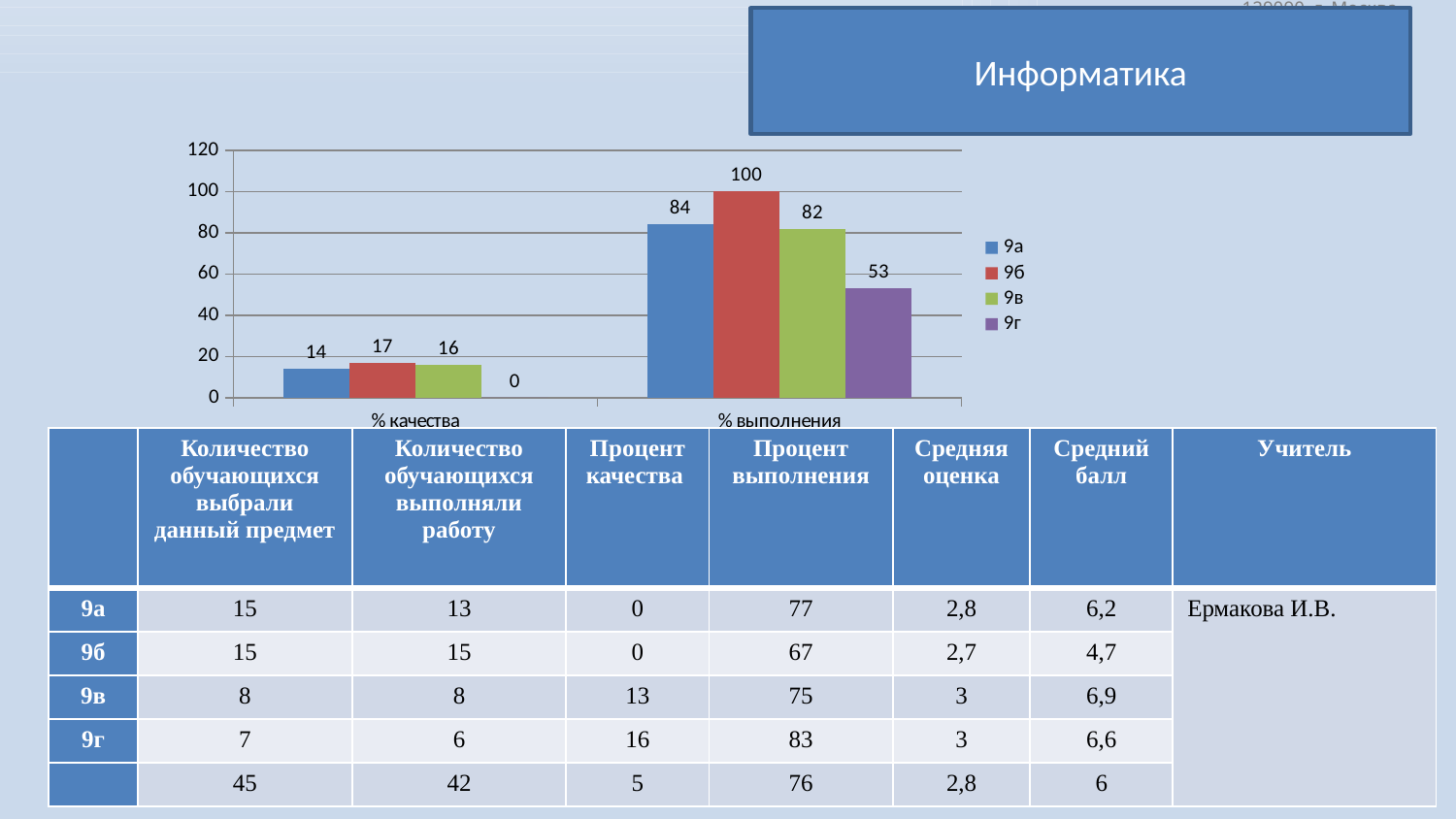
What is the value for 9г in the % выполнения category? 53 What kind of chart is shown on the slide? Bar chart What is the value for 9а in the % качества category? 14 Which series has the lowest value in the % качества category? 9г What is the value for 9б in the % выполнения category? 100 What colour represents the 9б series in the chart? Red Which series has the highest value in the % выполнения category? 9б What is the value for 9в in the % качества category? 16 How many series does the legend list? 4 Which is larger in the % выполнения category: 9а or 9в? 9а What is the difference between the % выполнения values for 9б and 9г? 47 How many categories are shown on the x axis? 2